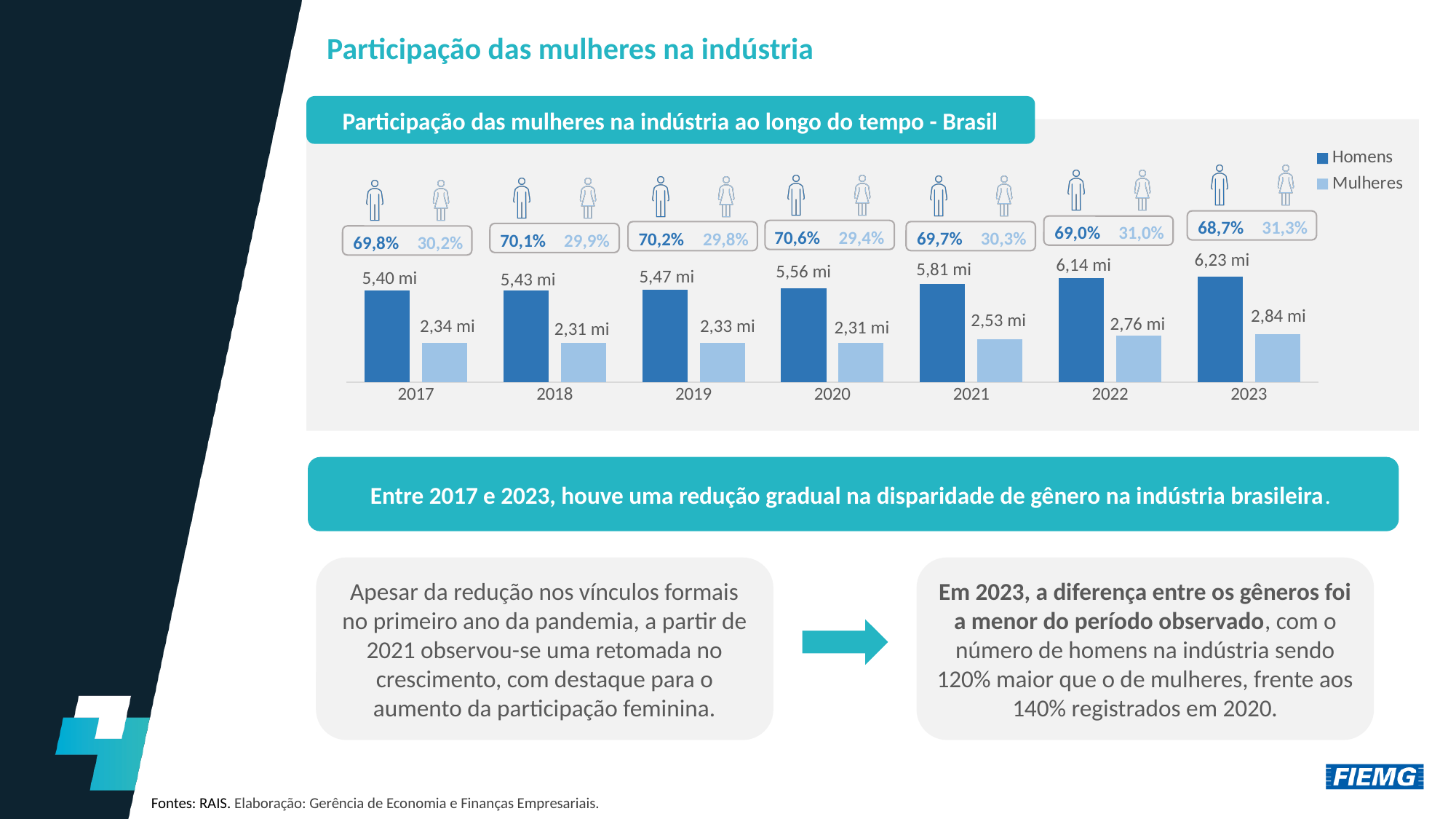
What is the value for Mulheres in 2021? 2,53 mi What is the difference between the Homens and Mulheres values in 2023? 3,39 mi What percentage share is shown for Mulheres in 2020? 29,4% Which is larger, the Mulheres value in 2022 or in 2019? 2022 What is the value for Homens in 2017? 5,40 mi How many series does the chart legend list? 2 What is the value for Mulheres in 2023? 2,84 mi In which year is the Homens value lowest? 2017 In which year is the Homens value highest? 2023 How many years are shown on the x axis of the chart? 7 By how much did the Mulheres value increase from 2017 to 2023? 0,50 mi In which year is the Mulheres value highest? 2023